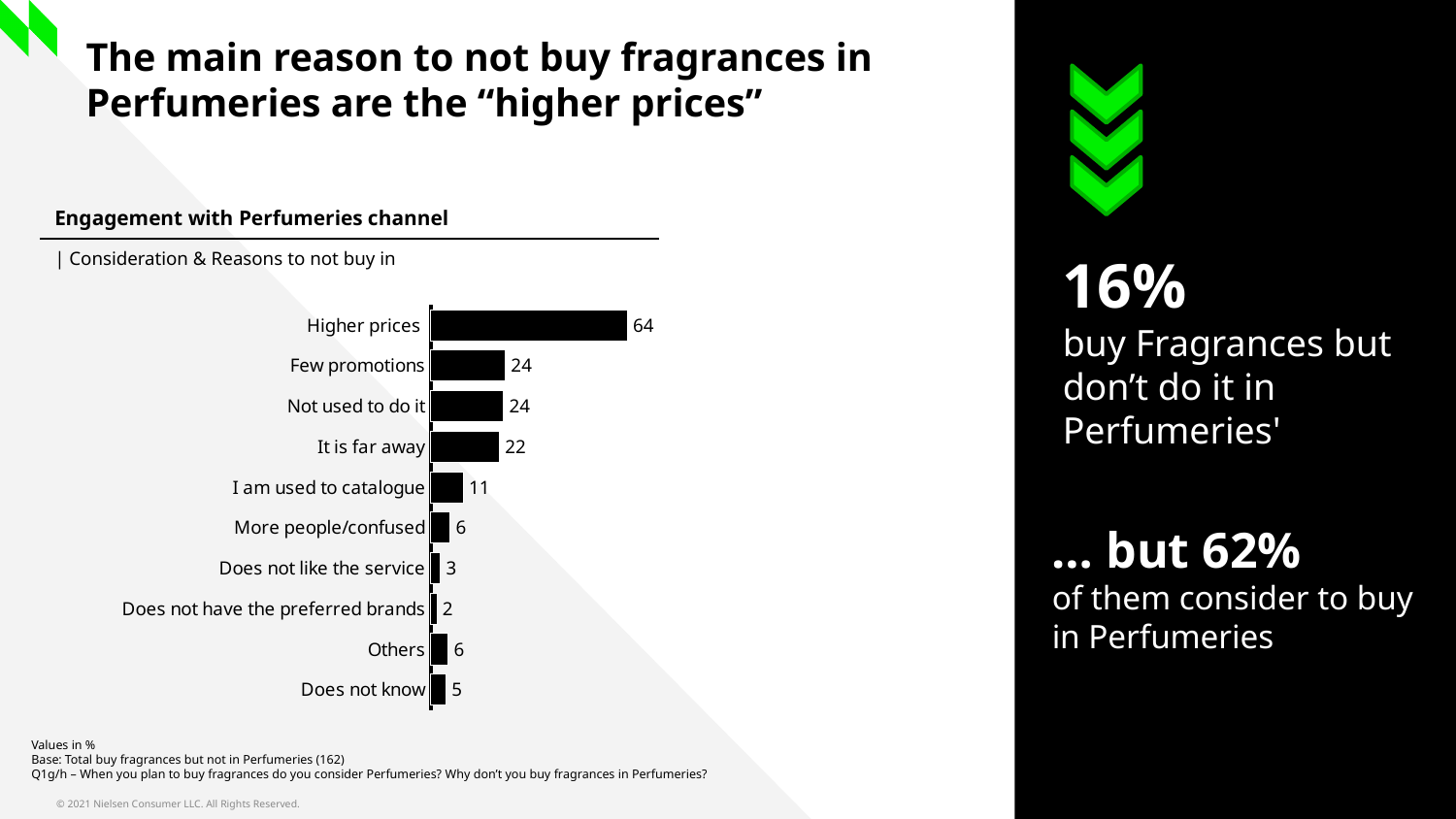
What is the value for "Higher prices"? 64 Which is larger, the value for "It is far away" or the value for "I am used to catalogue"? It is far away What is the difference between the values for "Others" and "Does not know"? 1 What is the value for "I am used to catalogue"? 11 Which reason has the lowest value? Does not have the preferred brands What is the value for "Does not have the preferred brands"? 2 What is the value for "It is far away"? 22 How many reasons are shown in the chart? 10 Which reason has the highest value? Higher prices What is the difference between the values for "Higher prices" and "Few promotions"? 40 What kind of chart is shown on the slide? Bar chart What is the subtitle shown above the chart? Consideration & Reasons to not buy in